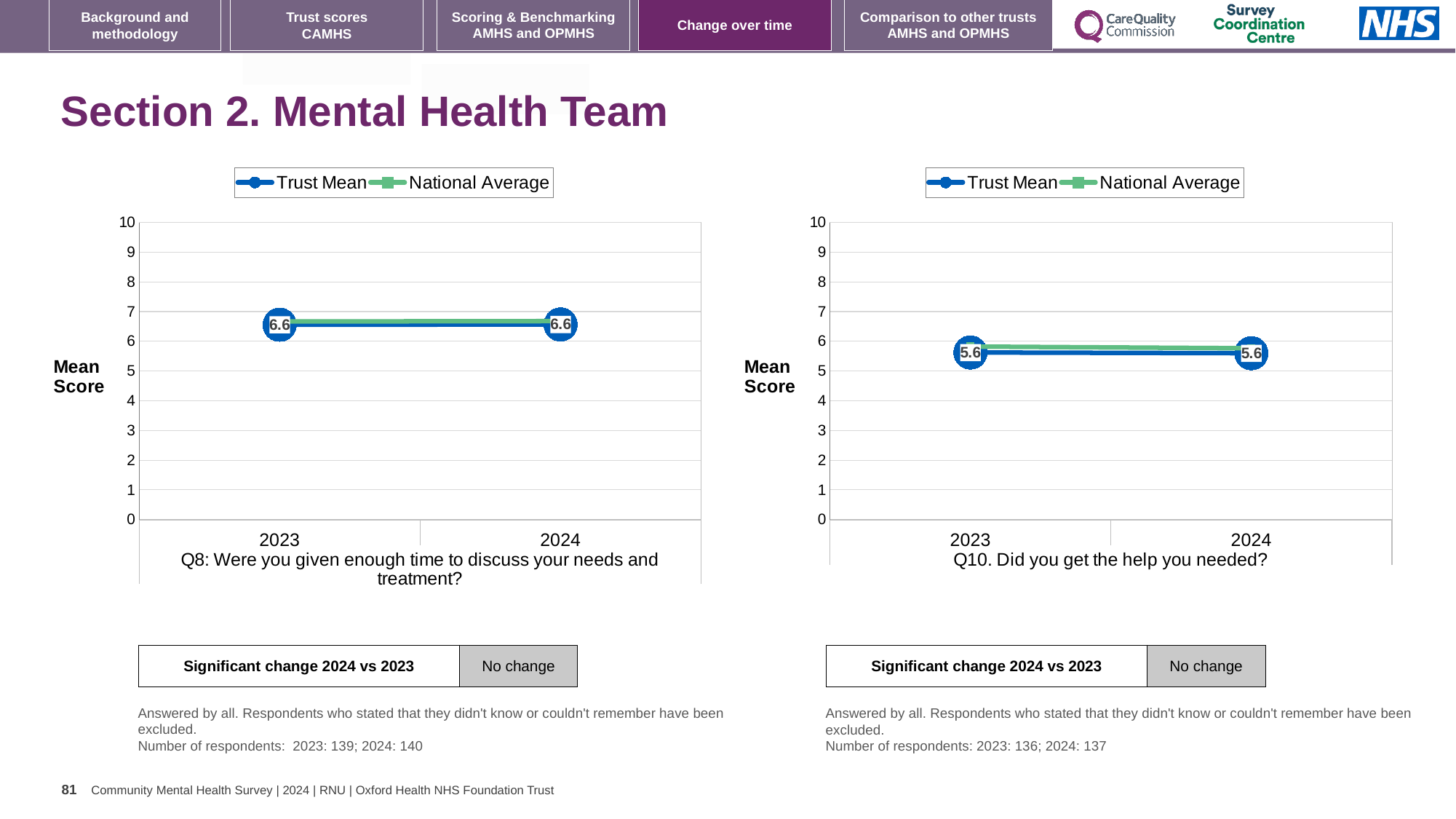
In the Q10 chart (right), what is the Trust Mean score for 2023? 5.6 In the Q10 chart (right), does the Trust Mean rise, fall or stay the same from 2023 to 2024? stays the same In the Q10 chart (right), what is the Trust Mean score for 2024? 5.6 How many years are shown on the x axis of the Q8 chart (left)? 2 In the Q8 chart (left), what is the difference between the Trust Mean in 2024 and in 2023? 0 In the Q10 chart (right), is the National Average for 2023 greater or less than 7? less In the Q8 chart (left), is the National Average for 2024 greater or less than 6? greater How many series does the legend of the Q10 chart (right) list? 2 In the Q8 chart (left), what is the Trust Mean score for 2024? 6.6 What kind of chart is the Q8 chart on the left? line chart In the Q8 chart (left), what is the Trust Mean score for 2023? 6.6 Which is larger: the 2024 Trust Mean in the Q8 chart (left) or the 2024 Trust Mean in the Q10 chart (right)? Q8 chart (left)